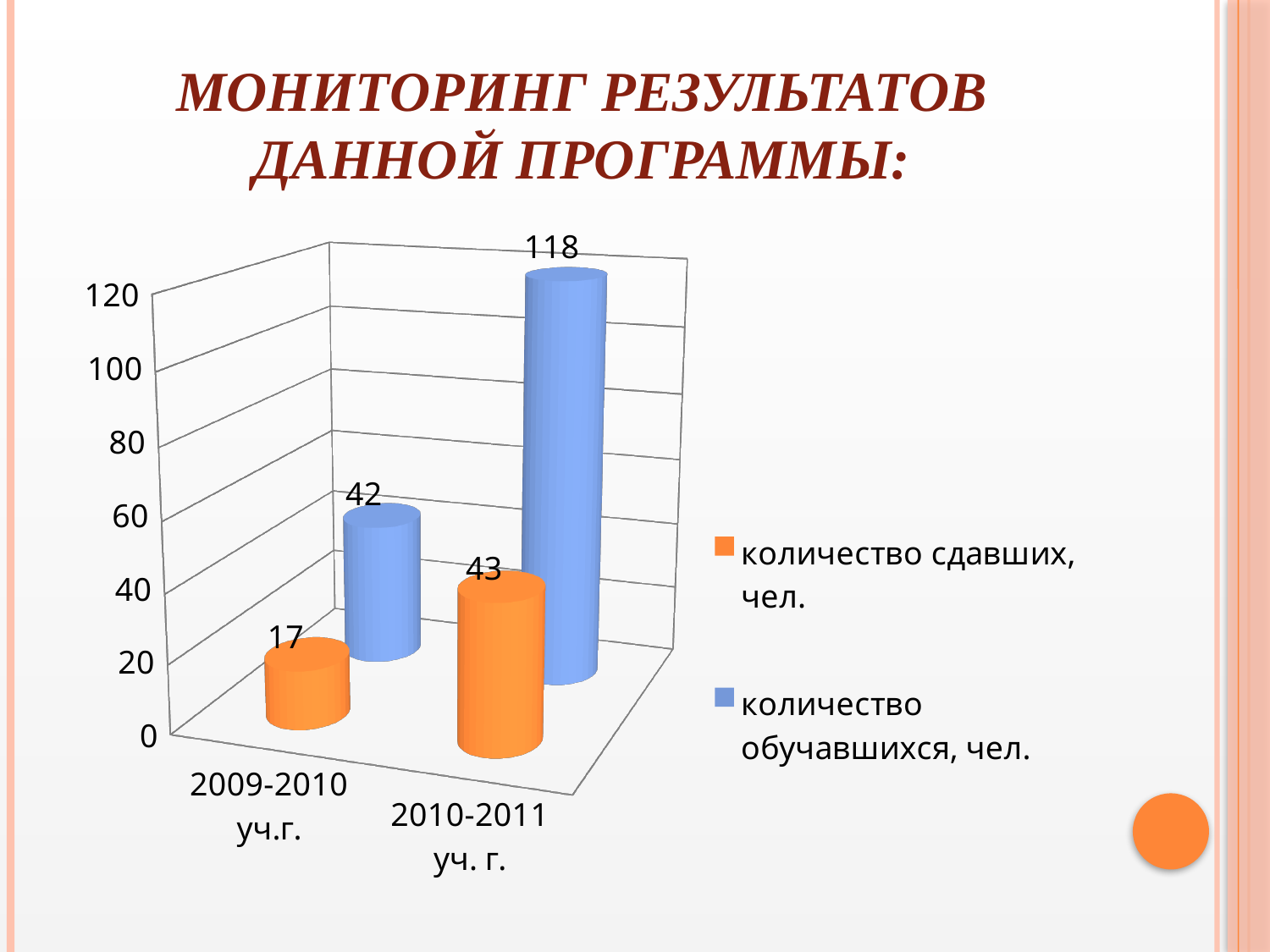
What is the value of 'количество сдавших, чел.' for 2010-2011 уч. г.? 43 Which category has the highest value for 'количество обучавшихся, чел.'? 2010-2011 уч. г. How many series does the legend list? 2 What is the difference between 'количество обучавшихся, чел.' and 'количество сдавших, чел.' for 2010-2011 уч. г.? 75 What kind of chart is shown on the slide? bar chart How many categories are shown on the x axis? 2 What is the value of 'количество обучавшихся, чел.' for 2009-2010 уч.г.? 42 Which is larger: 'количество сдавших, чел.' for 2010-2011 уч. г. or 'количество обучавшихся, чел.' for 2009-2010 уч.г.? количество сдавших, чел. for 2010-2011 уч. г. Which category has the lowest value for 'количество сдавших, чел.'? 2009-2010 уч.г. By how much did 'количество обучавшихся, чел.' increase from 2009-2010 уч.г. to 2010-2011 уч. г.? 76 What is the value of 'количество сдавших, чел.' for 2009-2010 уч.г.? 17 What is the value of 'количество обучавшихся, чел.' for 2010-2011 уч. г.? 118